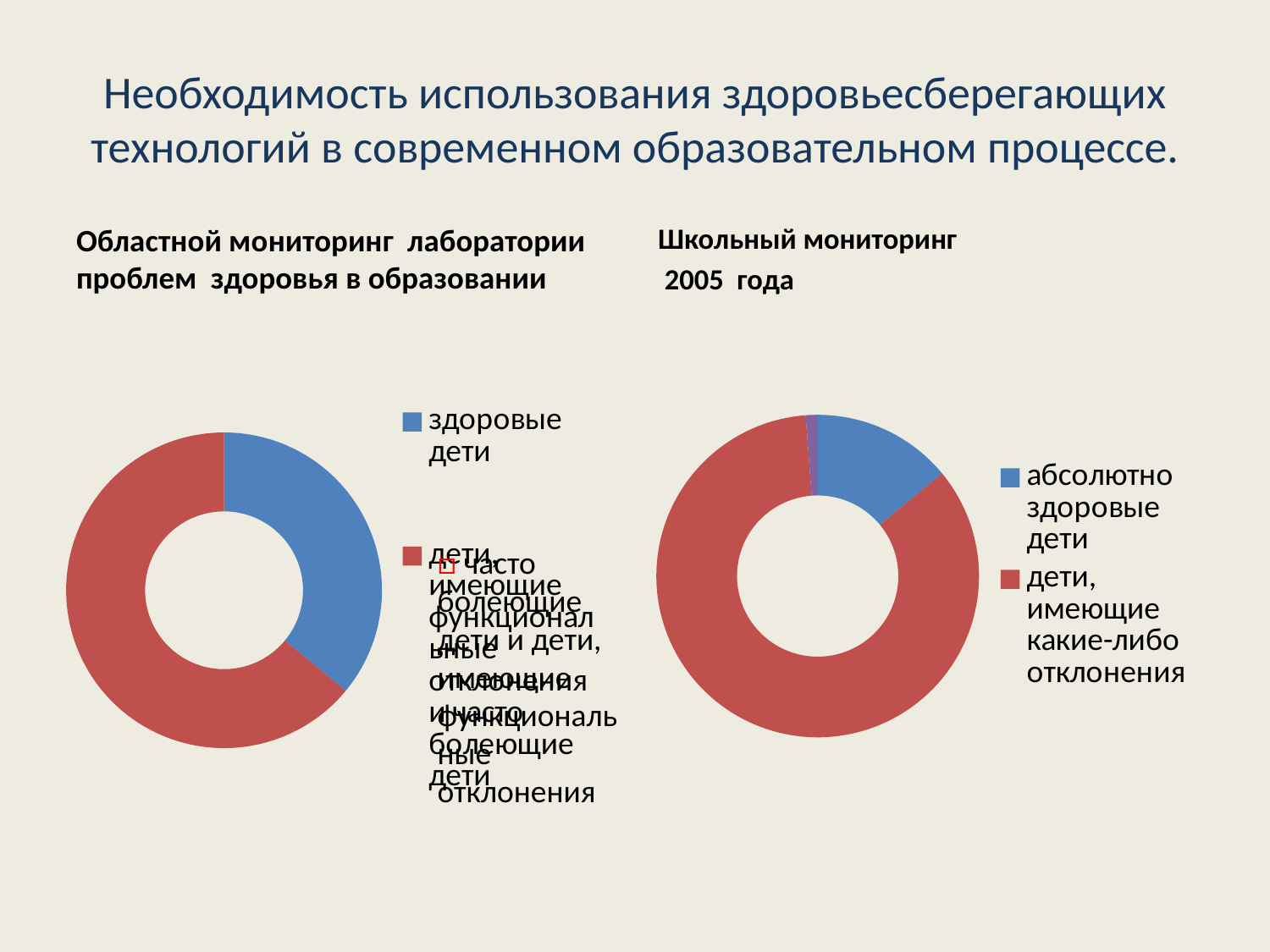
In the right chart (Школьный мониторинг 2005 года), what colour is the slice for 'абсолютно здоровые дети'? blue In the right chart (Школьный мониторинг 2005 года), which category has the largest share? дети, имеющие какие-либо отклонения In the left chart (Областной мониторинг), what colour is the slice for 'здоровые дети'? blue How many entries does the legend of the right chart (Школьный мониторинг 2005 года) list? 2 What kind of chart is the right chart, titled 'Школьный мониторинг 2005 года'? doughnut chart What kind of chart is the left chart, titled 'Областной мониторинг лаборатории проблем здоровья в образовании'? doughnut chart Is the share of 'здоровые дети' in the left chart (Областной мониторинг) greater or less than half of the doughnut? less How many entries does the legend of the left chart (Областной мониторинг) list? 2 Is the share of 'абсолютно здоровые дети' in the right chart (Школьный мониторинг 2005 года) greater or less than half of the doughnut? less In the right chart (Школьный мониторинг 2005 года), is the share of 'абсолютно здоровые дети' larger or smaller than the share of 'дети, имеющие какие-либо отклонения'? smaller In the left chart (Областной мониторинг), which category has the largest share: 'здоровые дети' or the red category of children with functional deviations and frequently ill children? дети, имеющие функциональные отклонения и часто болеющие дети In the left chart (Областной мониторинг), which category has the smallest share? здоровые дети